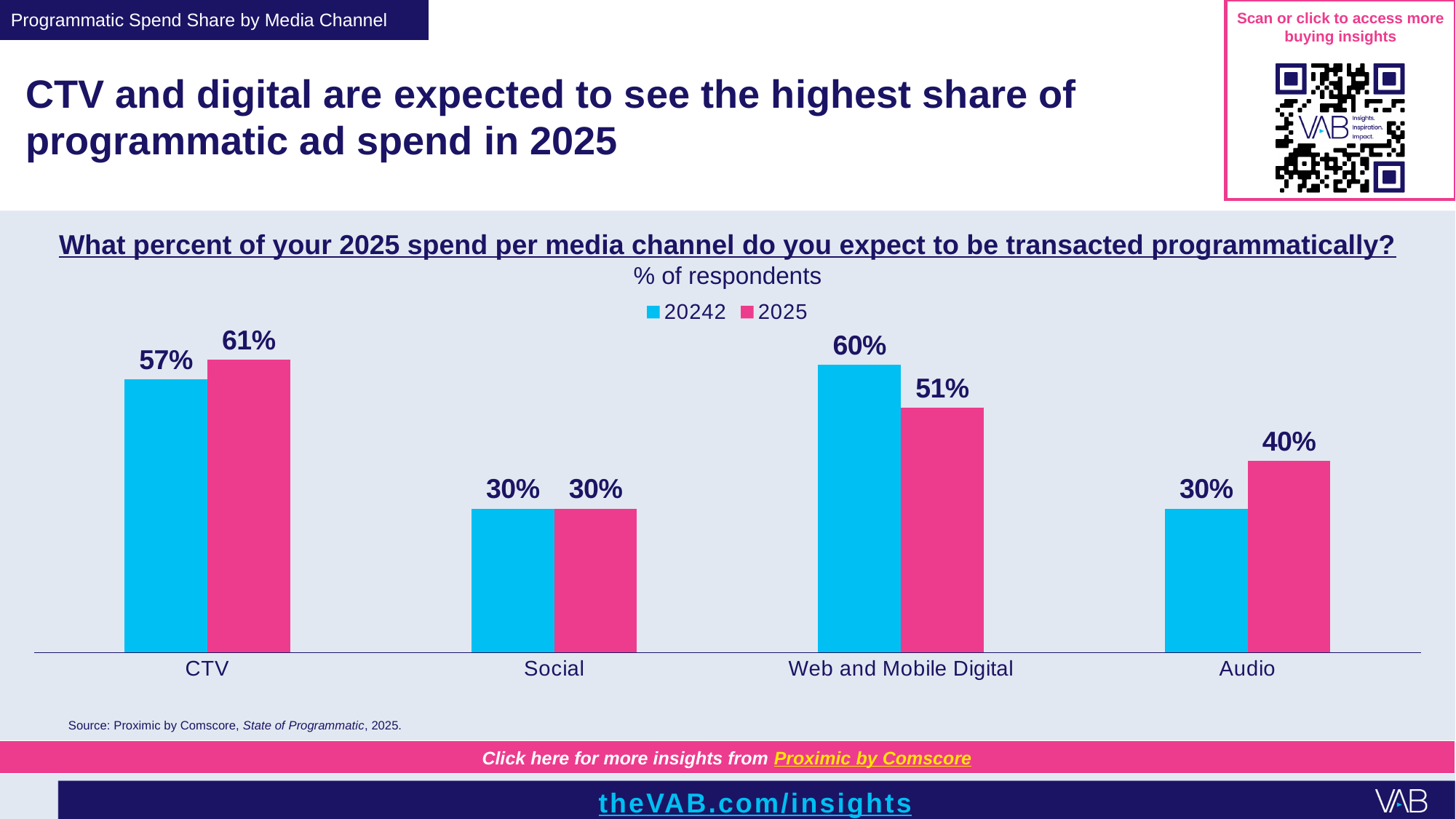
For Web and Mobile Digital, which is larger: the blue (20242) value or the 2025 value? The blue (20242) value What is the 2025 value for CTV? 61% How many series does the legend list? 2 What is the difference between the blue (20242) value and the 2025 value for Web and Mobile Digital? 9% What kind of chart is shown on the slide? Bar chart How many media channel categories are shown on the x axis? 4 What is the difference between the 2025 value and the blue (20242) value for Audio? 10% Which category has the lowest 2025 value? Social What colour are the bars for the 2025 series? Pink Which category has the highest 2025 value? CTV What is the 2025 value for Audio? 40% What is the value for Web and Mobile Digital in the blue series labelled 20242? 60%